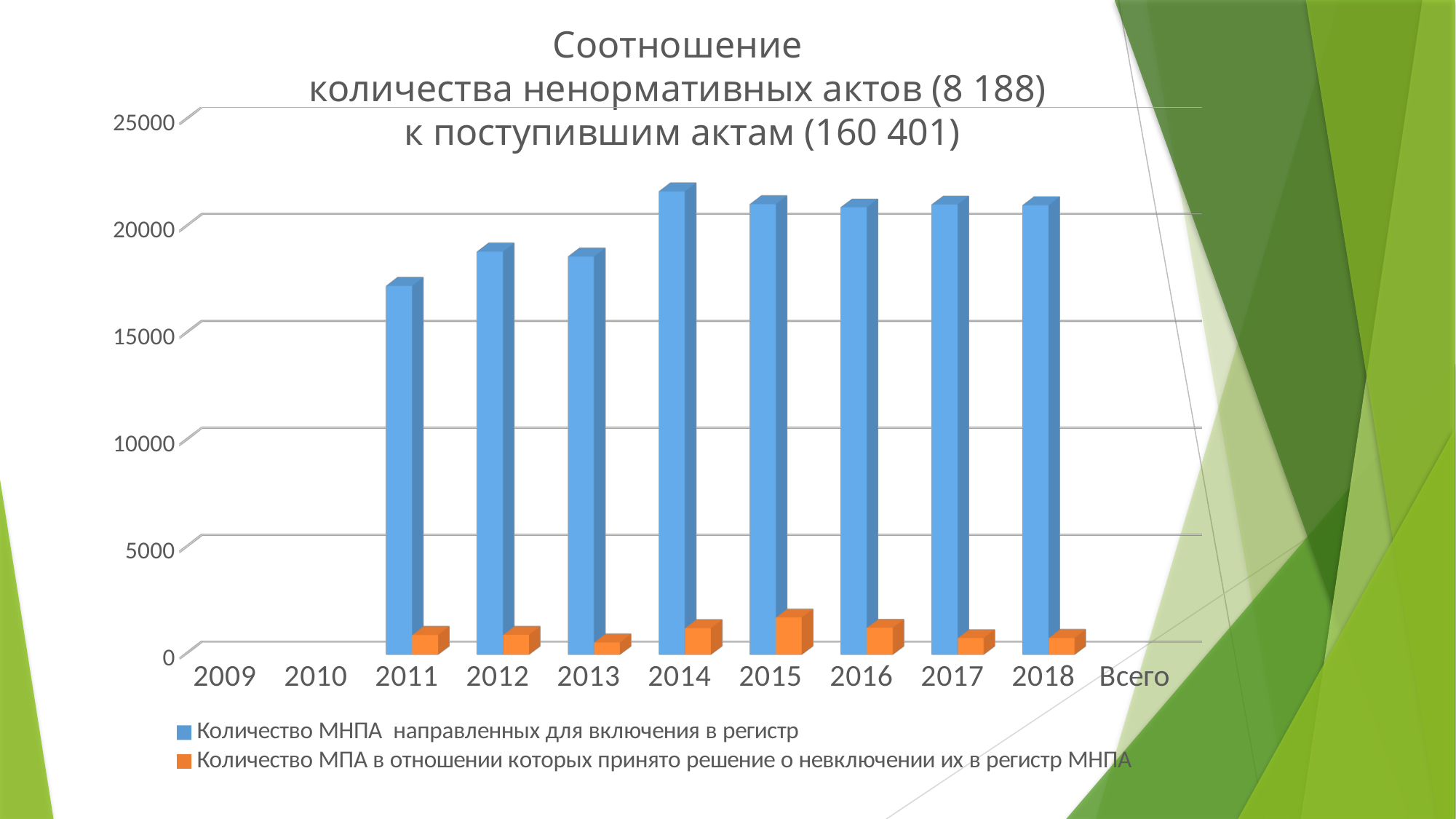
How many category labels are shown along the x axis? 11 Is the value for 'Количество МНПА направленных для включения в регистр' in 2013 greater or less than 20000? less Is the value for 'Количество МНПА направленных для включения в регистр' in 2011 greater or less than 15000? greater Which is larger for 'Количество МНПА направленных для включения в регистр': 2011 or 2012? 2012 Among the years with bars, which year has the lowest value for 'Количество МНПА направленных для включения в регистр'? 2011 Which year has the highest value for 'Количество МПА в отношении которых принято решение о невключении их в регистр МНПА'? 2015 Which colour represents 'Количество МПА в отношении которых принято решение о невключении их в регистр МНПА' in the legend? orange Is the value for 'Количество МПА в отношении которых принято решение о невключении их в регистр МНПА' in 2015 greater or less than 5000? less Among the years with bars, which year has the lowest value for 'Количество МПА в отношении которых принято решение о невключении их в регистр МНПА'? 2013 Which year has the highest value for 'Количество МНПА направленных для включения в регистр'? 2014 How many series does the legend list? 2 What kind of chart is shown on the slide? bar chart